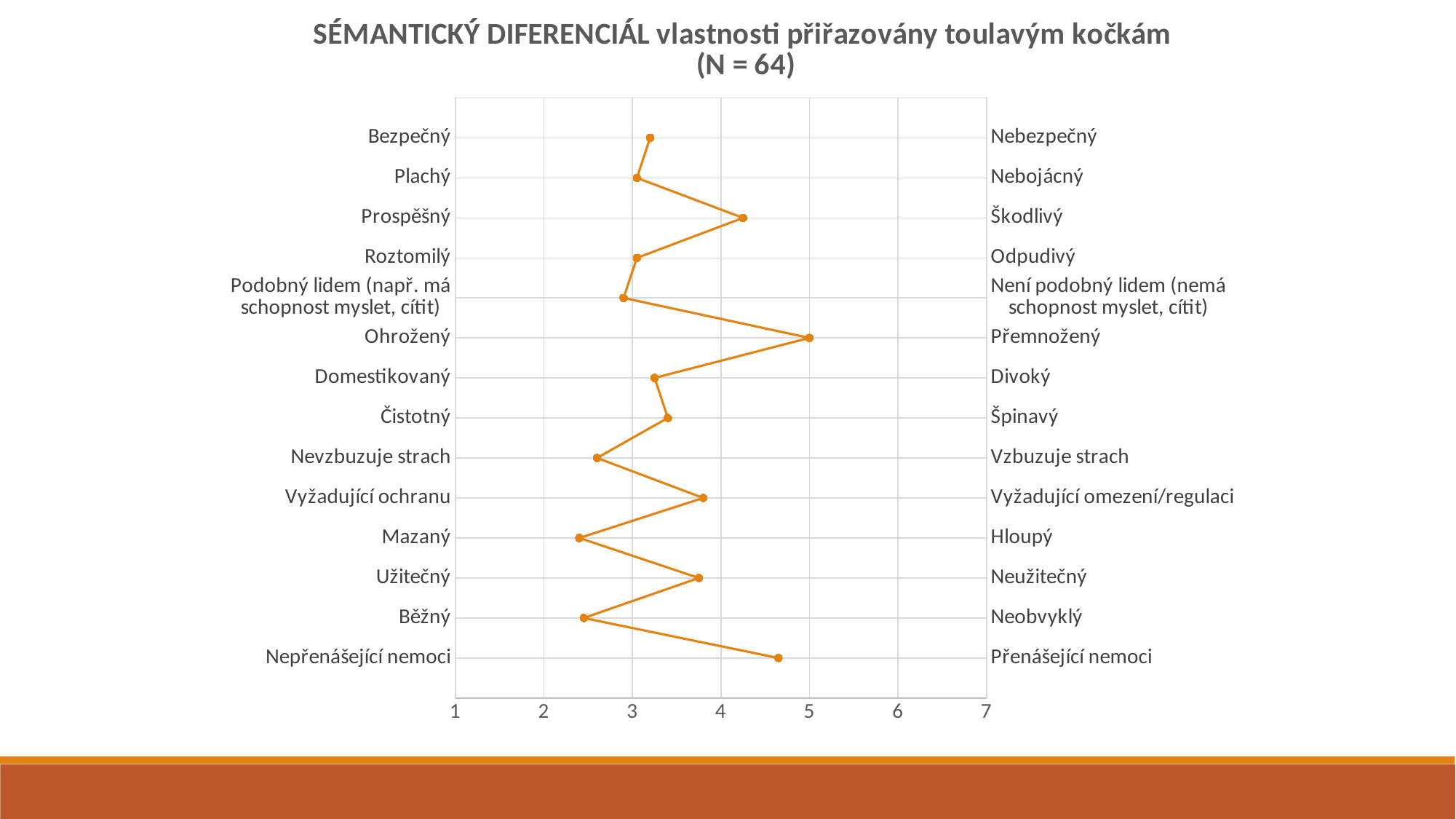
What is the range of the horizontal axis? 1 to 7 What sample size (N) is stated in the chart title? N = 64 Is the value for Nepřenášející nemoci – Přenášející nemoci greater or less than 4? greater Which has the larger value: Prospěšný – Škodlivý or Plachý – Nebojácný? Prospěšný – Škodlivý How many attribute pairs (categories) are plotted on the chart? 14 What kind of chart is shown on the slide? line chart Which has the larger value: Užitečný – Neužitečný or Běžný – Neobvyklý? Užitečný – Neužitečný Is the value for Mazaný – Hloupý greater or less than 3? less Which attribute pair has the highest value on the chart? Ohrožený – Přemnožený What is the value for the Ohrožený – Přemnožený pair? 5 Is the value for Vyžadující ochranu – Vyžadující omezení/regulaci greater or less than 4? less